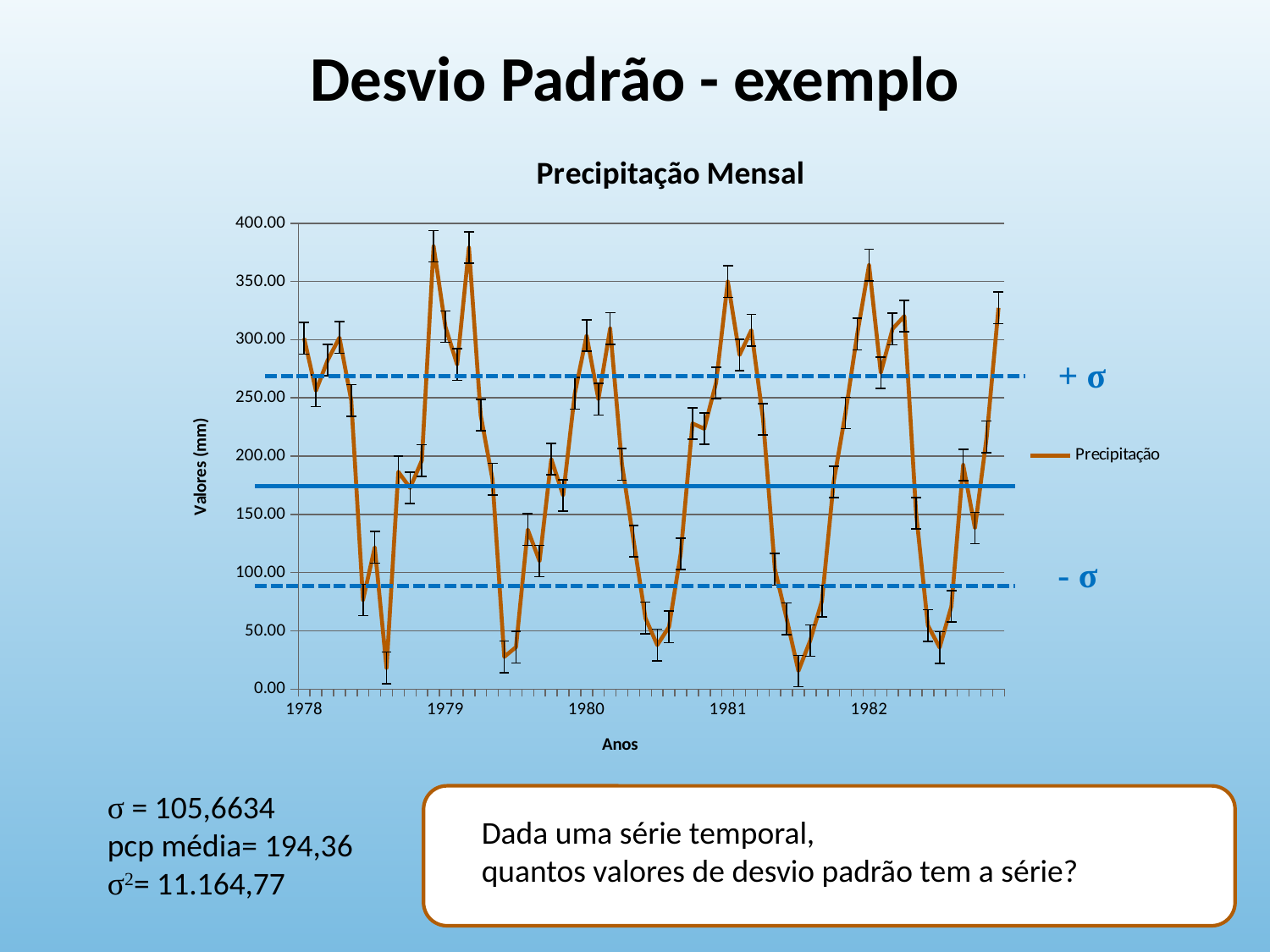
Is the value for Precipitação at the 1981 tick greater or less than 300.00? greater Is the value for Precipitação at the 1980 tick greater or less than 250.00? greater Is the value for Precipitação at the 1982 tick greater or less than 300.00? greater How many series does the chart legend list? 1 How many year labels are shown on the x axis? 5 What is the title of the chart? Precipitação Mensal What kind of chart is shown on the slide? line chart What is the name of the series shown in the legend? Precipitação